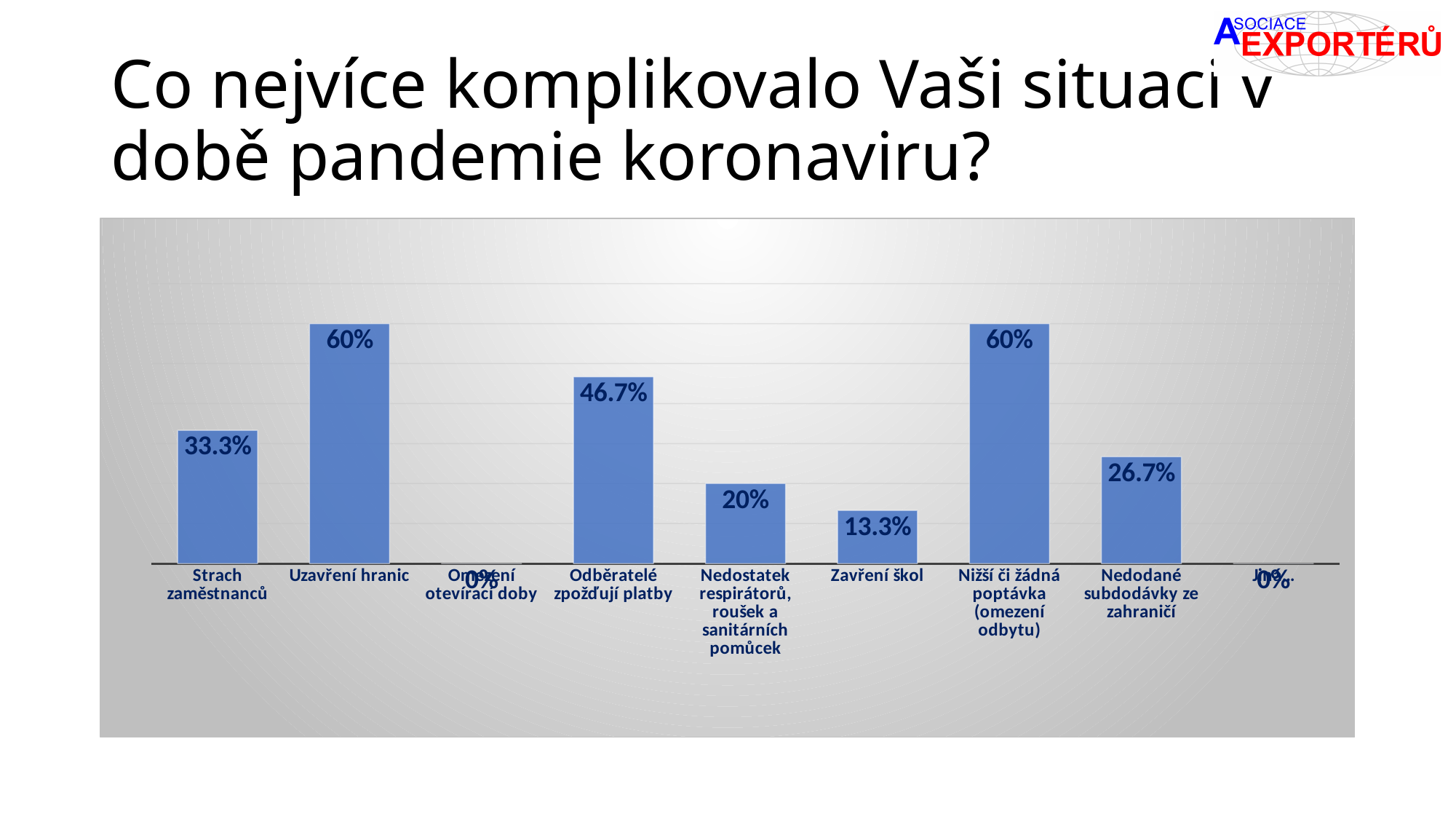
What is the value for Odběratelé zpožďují platby? 46.7% What is the difference between the values for Uzavření hranic and Strach zaměstnanců? 26.7% Which category has the lowest non-zero value? Zavření škol What is the value for Strach zaměstnanců? 33.3% How many categories are shown in the chart? 9 What is the value for Zavření škol? 13.3% Which two categories share the highest value in the chart? Uzavření hranic and Nižší či žádná poptávka (omezení odbytu) What is the value for Nedodané subdodávky ze zahraničí? 26.7% What is the highest value shown in the chart? 60% What is the value for Nedostatek respirátorů, roušek a sanitárních pomůcek? 20% What kind of chart is shown on the slide? Bar chart Which is larger, the value for Strach zaměstnanců or the value for Nedodané subdodávky ze zahraničí? Strach zaměstnanců